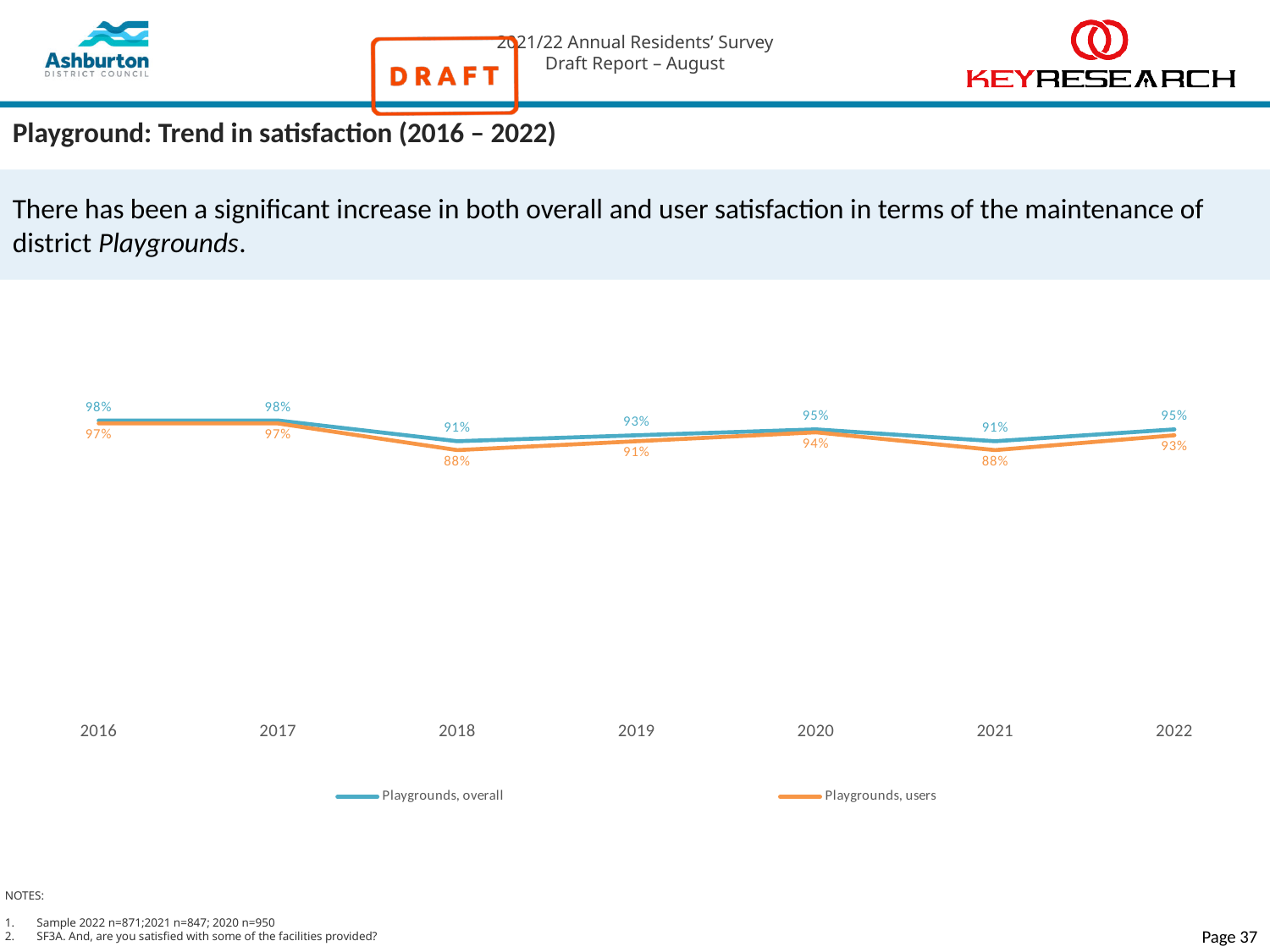
What is the value for Playgrounds, users in 2020? 94% What is the value for Playgrounds, overall in 2022? 95% Did Playgrounds, overall rise or fall from 2021 to 2022? Rise What is the value for Playgrounds, users in 2018? 88% What is the difference between Playgrounds, overall and Playgrounds, users in 2021? 3 percentage points Which is larger in 2019: Playgrounds, overall or Playgrounds, users? Playgrounds, overall What type of chart is shown on the slide? Line chart In which years does Playgrounds, overall reach its highest value? 2016 and 2017 How many years are plotted along the x axis? 7 How many series does the legend list? 2 What is the title of the chart? Playground: Trend in satisfaction (2016 – 2022) In which year is Playgrounds, users at its lowest value? 2018 and 2021